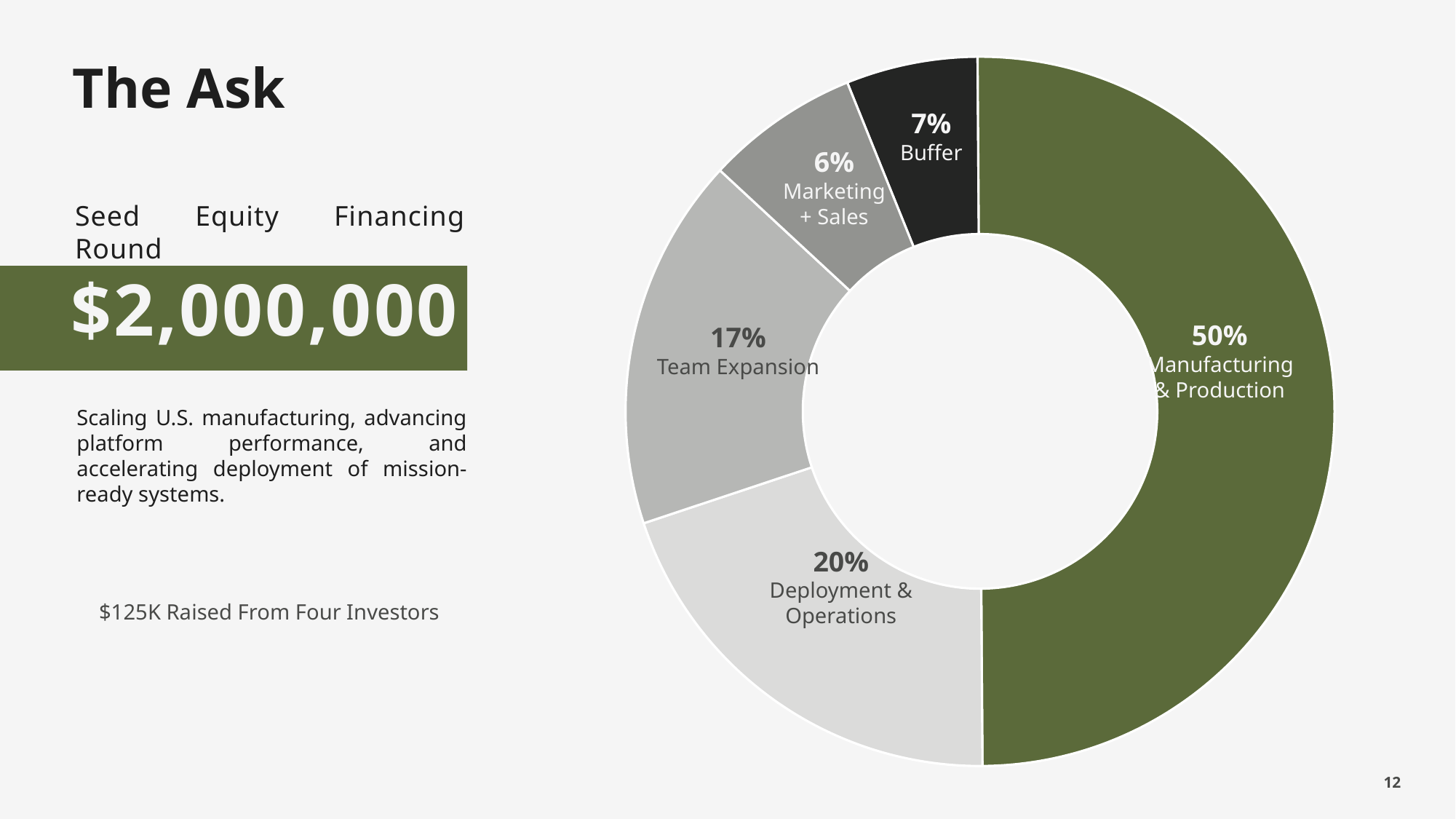
What percentage is set aside as Buffer? 7% Which category is shown in green on the chart? Manufacturing & Production How many categories are shown in the chart? 5 What share of the funding goes to Manufacturing & Production? 50% What share is allocated to Marketing + Sales? 6% What is the difference in percentage points between Deployment & Operations and Team Expansion? 3 What percentage is allocated to Team Expansion? 17% What percentage is allocated to Deployment & Operations? 20% Which is larger, the Buffer share or the Marketing + Sales share? Buffer Which category receives the smallest share of the funding? Marketing + Sales What kind of chart is shown on the slide? Doughnut chart Which category receives the largest share of the funding? Manufacturing & Production